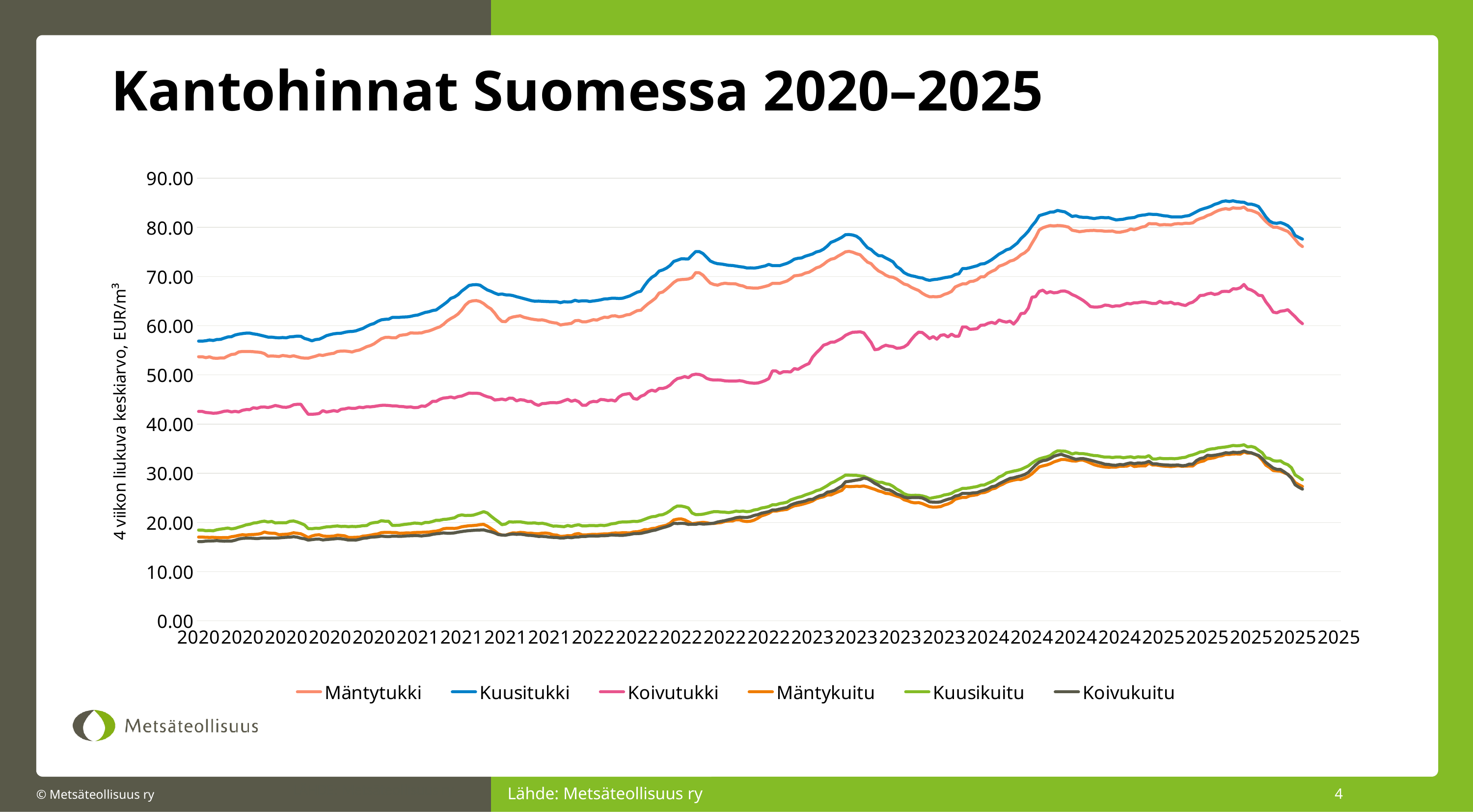
What kind of chart is shown on the slide? line chart What is the title of the chart? Kantohinnat Suomessa 2020–2025 Which series has higher values, Koivutukki or Kuusikuitu? Koivutukki Is the value for Kuusitukki at the start of 2020 greater or less than 50? greater How many series does the legend list? 6 Is the highest value reached by Koivutukki greater or less than 70? less Is the peak value for Kuusitukki in 2025 greater or less than 80? greater Which series has higher values, Kuusitukki or Mäntytukki? Kuusitukki Overall, do the Kuusitukki values rise or fall from 2020 to 2025? rise Which series has the highest values throughout the chart? Kuusitukki What is the label on the vertical axis? 4 viikon liukuva keskiarvo, EUR/m³